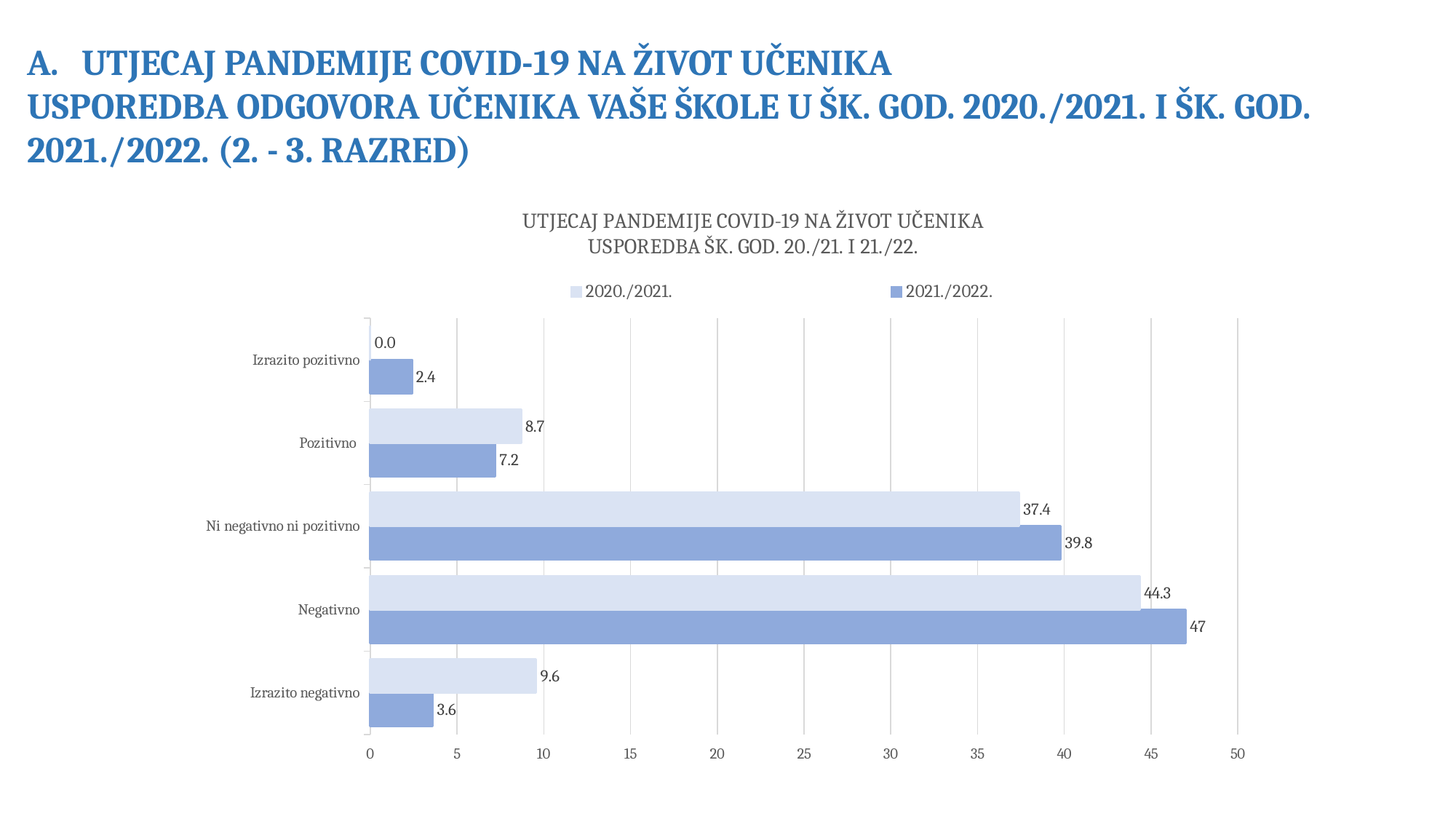
Which is larger for Pozitivno: the 2020./2021. value or the 2021./2022. value? 2020./2021. Which category has the highest value in the 2021./2022. series? Negativno What kind of chart is shown on the slide? Bar chart What is the value for Negativno in the 2021./2022. series? 47 What is the difference between the 2021./2022. and 2020./2021. values for Negativno? 2.7 What is the value for Ni negativno ni pozitivno in the 2020./2021. series? 37.4 Which category has the lowest value in the 2020./2021. series? Izrazito pozitivno How many categories are shown on the chart? 5 How many series does the legend list? 2 Is the 2021./2022. value for Ni negativno ni pozitivno greater or less than 35? greater What is the value for Izrazito pozitivno in the 2020./2021. series? 0.0 What is the difference between the 2020./2021. and 2021./2022. values for Izrazito negativno? 6.0